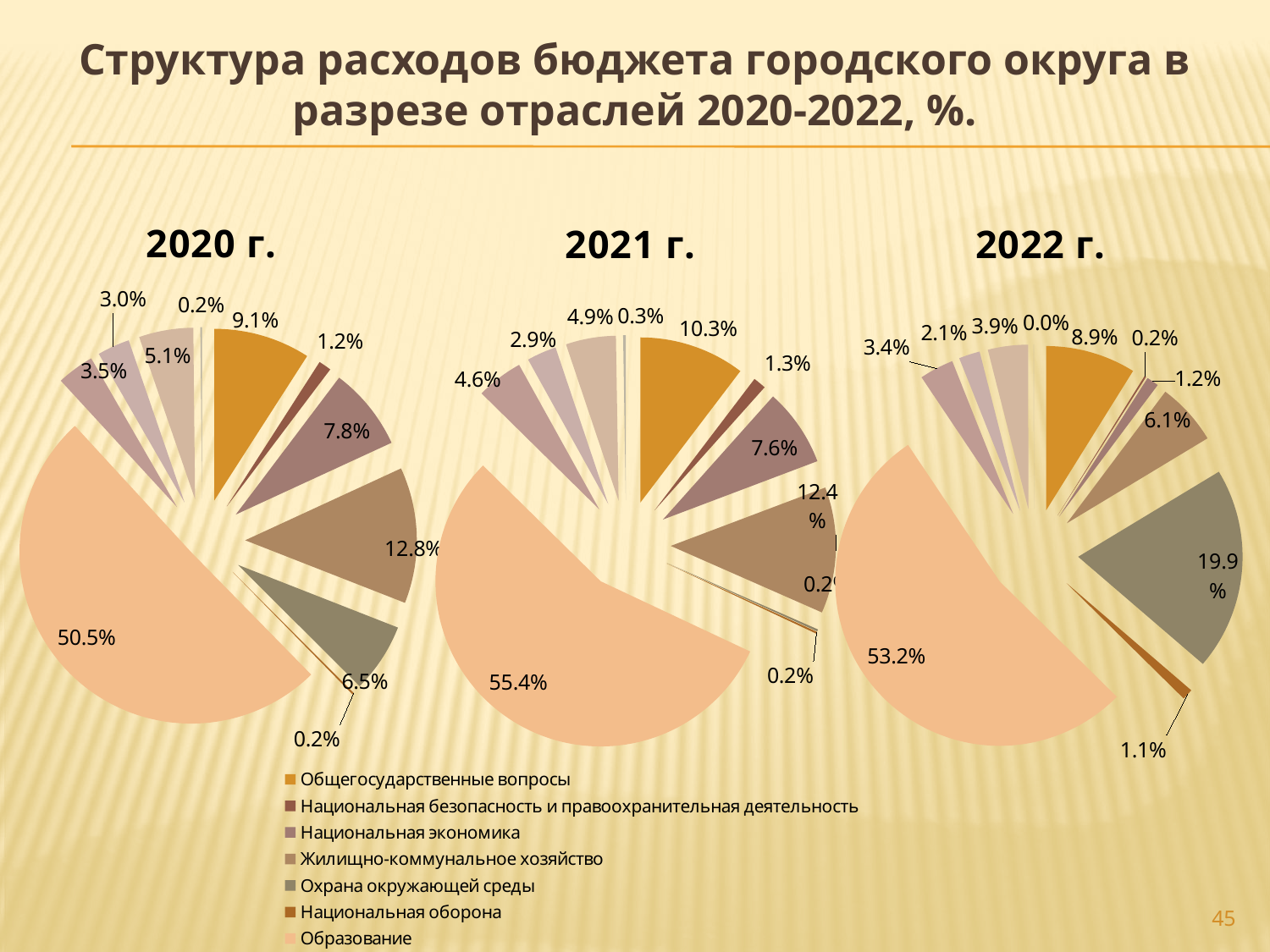
By how many percentage points does the Образование share in the 2021 г. pie chart exceed that in the 2020 г. pie chart? 4.9 In the 2022 г. pie chart, what share is shown for Общегосударственные вопросы (the orange slice)? 8.9% In the 2022 г. pie chart, what share is shown for Образование (the largest slice)? 53.2% In the 2020 г. pie chart, what share is shown for Общегосударственные вопросы (the orange slice)? 9.1% In the 2020 г. pie chart, what share is shown for Образование (the largest slice)? 50.5% What is the first entry listed in the legend below the pie charts? Общегосударственные вопросы Across the three pie charts, in which year is the Образование share the largest? 2021 г. In the 2021 г. pie chart, what share is shown for Образование (the largest slice)? 55.4% Which is larger: the Образование share in the 2020 г. pie chart or in the 2022 г. pie chart? 2022 г. What kind of charts are shown on the slide? Pie charts In the 2021 г. pie chart, what share is shown for Общегосударственные вопросы (the orange slice)? 10.3% How many pie charts are on the slide? 3